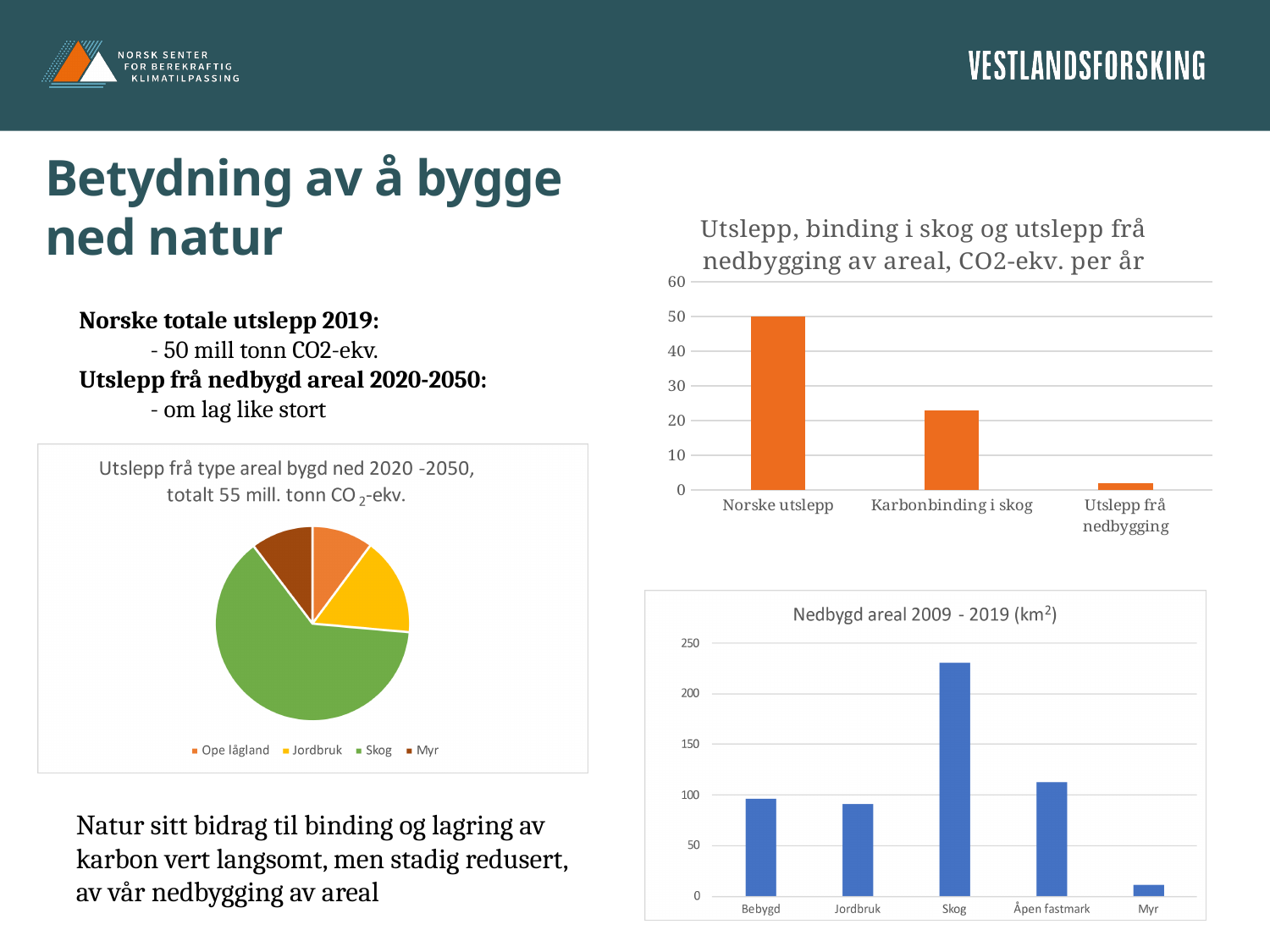
In the chart titled 'Nedbygd areal 2009 - 2019 (km2)', how many categories are shown on the x axis? 5 In the chart titled 'Utslepp, binding i skog og utslepp frå nedbygging av areal, CO2-ekv. per år', is the value for Karbonbinding i skog greater or less than 30? less In the chart titled 'Utslepp, binding i skog og utslepp frå nedbygging av areal, CO2-ekv. per år', which category has the lowest value? Utslepp frå nedbygging In the chart titled 'Nedbygd areal 2009 - 2019 (km2)', is the value for Åpen fastmark greater or less than 100? greater What kind of chart is the one titled 'Utslepp, binding i skog og utslepp frå nedbygging av areal, CO2-ekv. per år'? bar chart In the chart titled 'Nedbygd areal 2009 - 2019 (km2)', is the value for Skog greater or less than 200? greater How many entries does the legend of the pie chart titled 'Utslepp frå type areal bygd ned 2020 -2050' list? 4 In the chart titled 'Utslepp, binding i skog og utslepp frå nedbygging av areal, CO2-ekv. per år', how many categories are shown on the x axis? 3 In the chart titled 'Nedbygd areal 2009 - 2019 (km2)', which category has the lowest value? Myr In the chart titled 'Nedbygd areal 2009 - 2019 (km2)', which category has the highest value? Skog In the pie chart titled 'Utslepp frå type areal bygd ned 2020 -2050', which category has the largest slice? Skog In the chart titled 'Utslepp, binding i skog og utslepp frå nedbygging av areal, CO2-ekv. per år', which category has the highest value? Norske utslepp